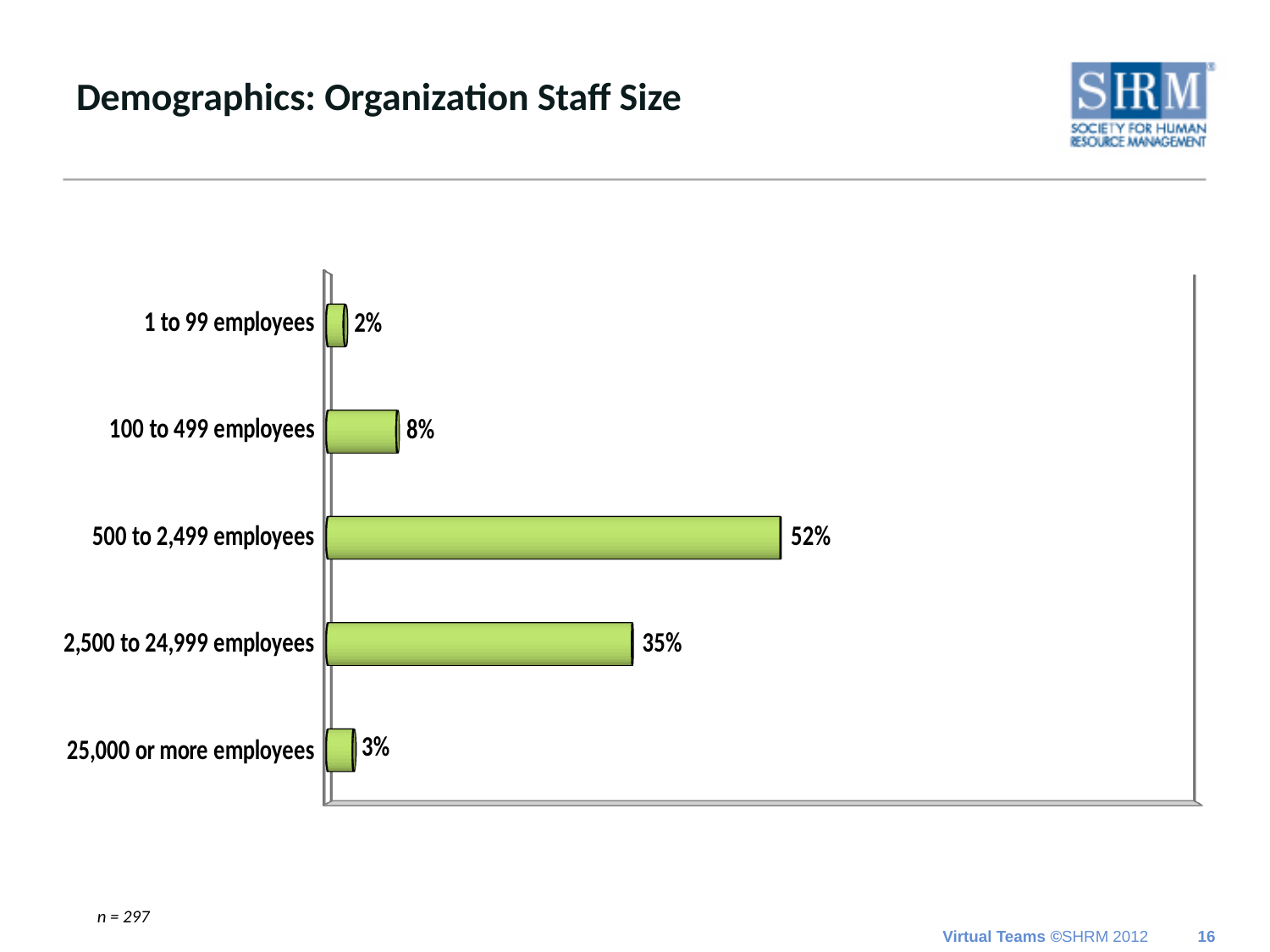
Which has a larger percentage: 100 to 499 employees or 25,000 or more employees? 100 to 499 employees What percentage of organizations have 25,000 or more employees? 3% What is the difference in percentage between the 500 to 2,499 employees category and the 2,500 to 24,999 employees category? 17% What type of chart is shown on the slide? Bar chart What percentage of organizations have 1 to 99 employees? 2% What is the sample size (n) noted on the slide? n = 297 How many staff size categories are shown in the chart? 5 What is the difference in percentage between the 100 to 499 employees category and the 1 to 99 employees category? 6% Which staff size category has the lowest percentage? 1 to 99 employees What percentage of organizations have 2,500 to 24,999 employees? 35% Which staff size category has the highest percentage? 500 to 2,499 employees What percentage of organizations have 500 to 2,499 employees? 52%